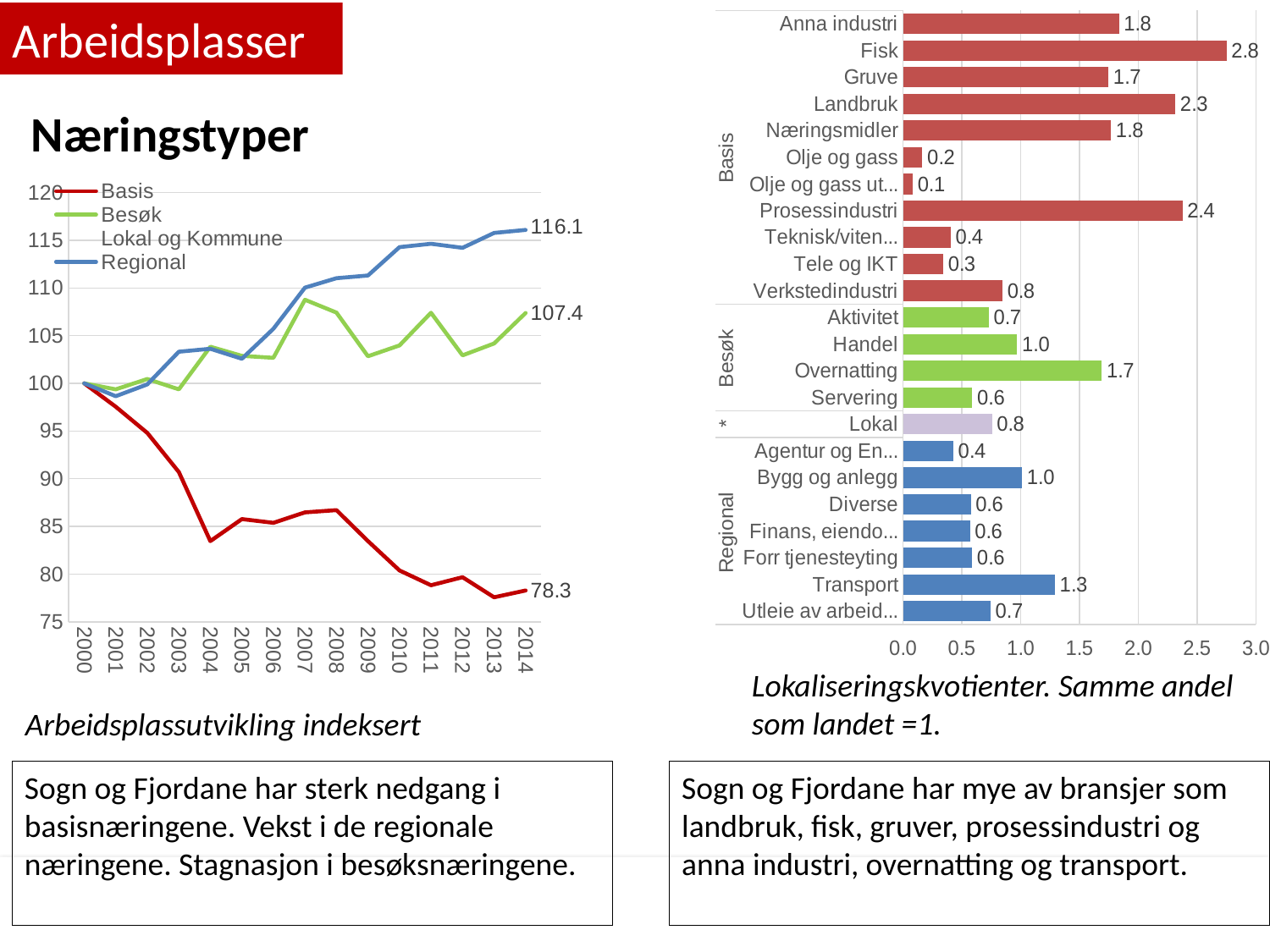
In the bar chart on the right, which is larger, the value for Transport or the value for Bygg og anlegg? Transport In the line chart on the left, does the Basis series rise or fall from 2000 to 2014? fall What kind of chart is the chart on the right? bar chart In the bar chart on the right, what is the difference between the values for Prosessindustri and Landbruk? 0.1 In the line chart on the left, how many series does the legend list? 4 In the line chart on the left, what is the value of the Regional series in 2014? 116.1 In the bar chart on the right, which category has the highest value? Fisk In the bar chart on the right, how many bars are plotted? 23 In the line chart on the left, what is the value of the Basis series in 2014? 78.3 In the bar chart on the right, what is the value for Fisk? 2.8 In the bar chart on the right, which category has the lowest value? Olje og gass ut... In the bar chart on the right, what is the value for Overnatting? 1.7